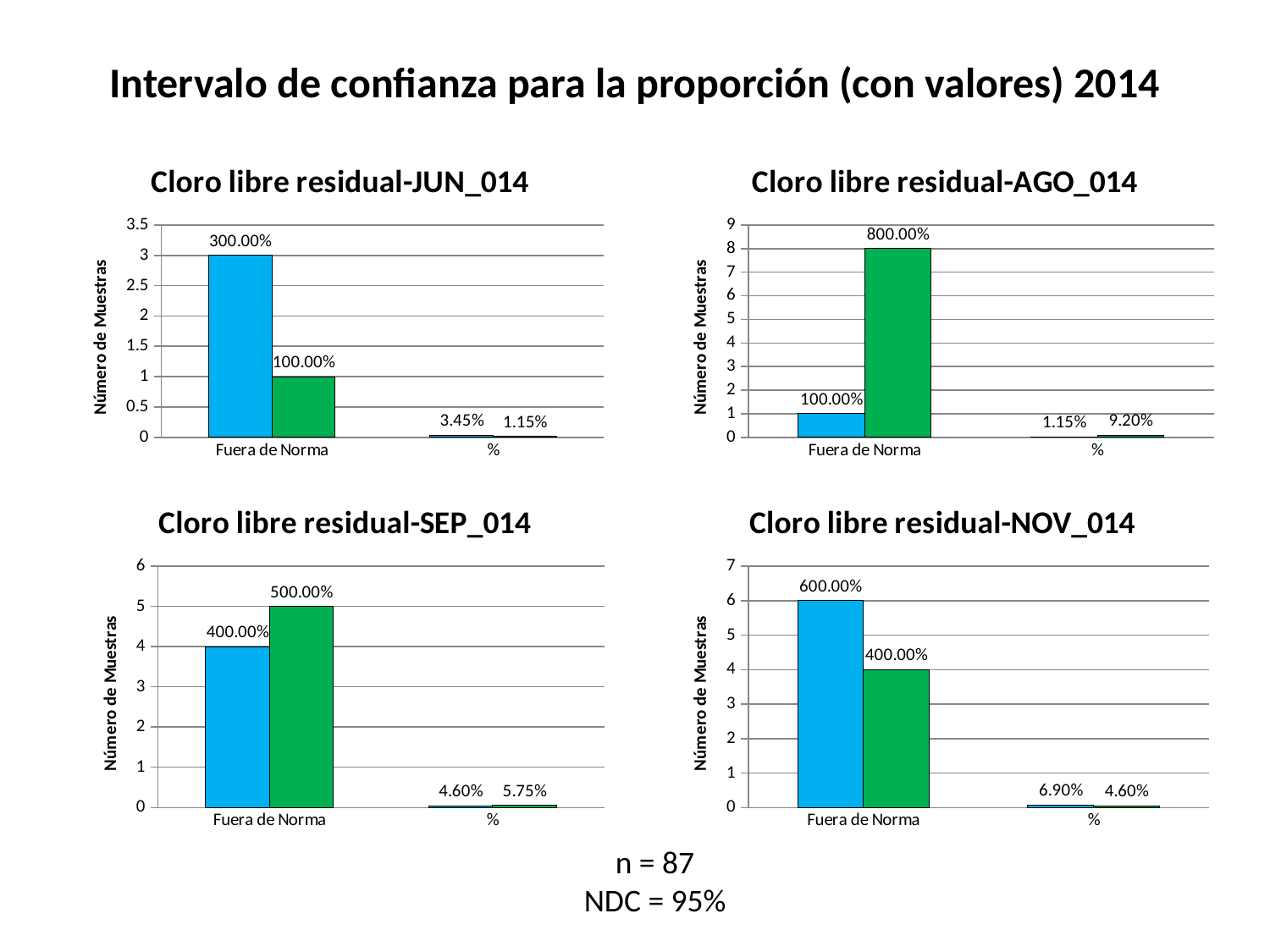
What is the y-axis title of the 'Cloro libre residual-NOV_014' chart? Número de Muestras In the 'Cloro libre residual-JUN_014' chart, what is the data label on the green bar for 'Fuera de Norma'? 100.00% In the 'Cloro libre residual-AGO_014' chart, what is the data label on the green bar for 'Fuera de Norma'? 800.00% In the 'Cloro libre residual-AGO_014' chart, which bar for 'Fuera de Norma' is taller, the blue one or the green one? the green one In the 'Cloro libre residual-NOV_014' chart, what is the data label on the blue bar in the '%' category? 6.90% In the 'Cloro libre residual-SEP_014' chart, what is the data label on the blue bar for 'Fuera de Norma'? 400.00% In the 'Cloro libre residual-NOV_014' chart, which bar for 'Fuera de Norma' is taller, the blue one or the green one? the blue one How many categories are shown on the x axis of the 'Cloro libre residual-SEP_014' chart? 2 What kind of chart is 'Cloro libre residual-JUN_014'? bar chart In the 'Cloro libre residual-JUN_014' chart, what is the data label on the blue bar for 'Fuera de Norma'? 300.00% In the 'Cloro libre residual-SEP_014' chart, what is the difference between the green and blue 'Fuera de Norma' data labels? 100.00% In the 'Cloro libre residual-AGO_014' chart, what is the data label on the green bar in the '%' category? 9.20%